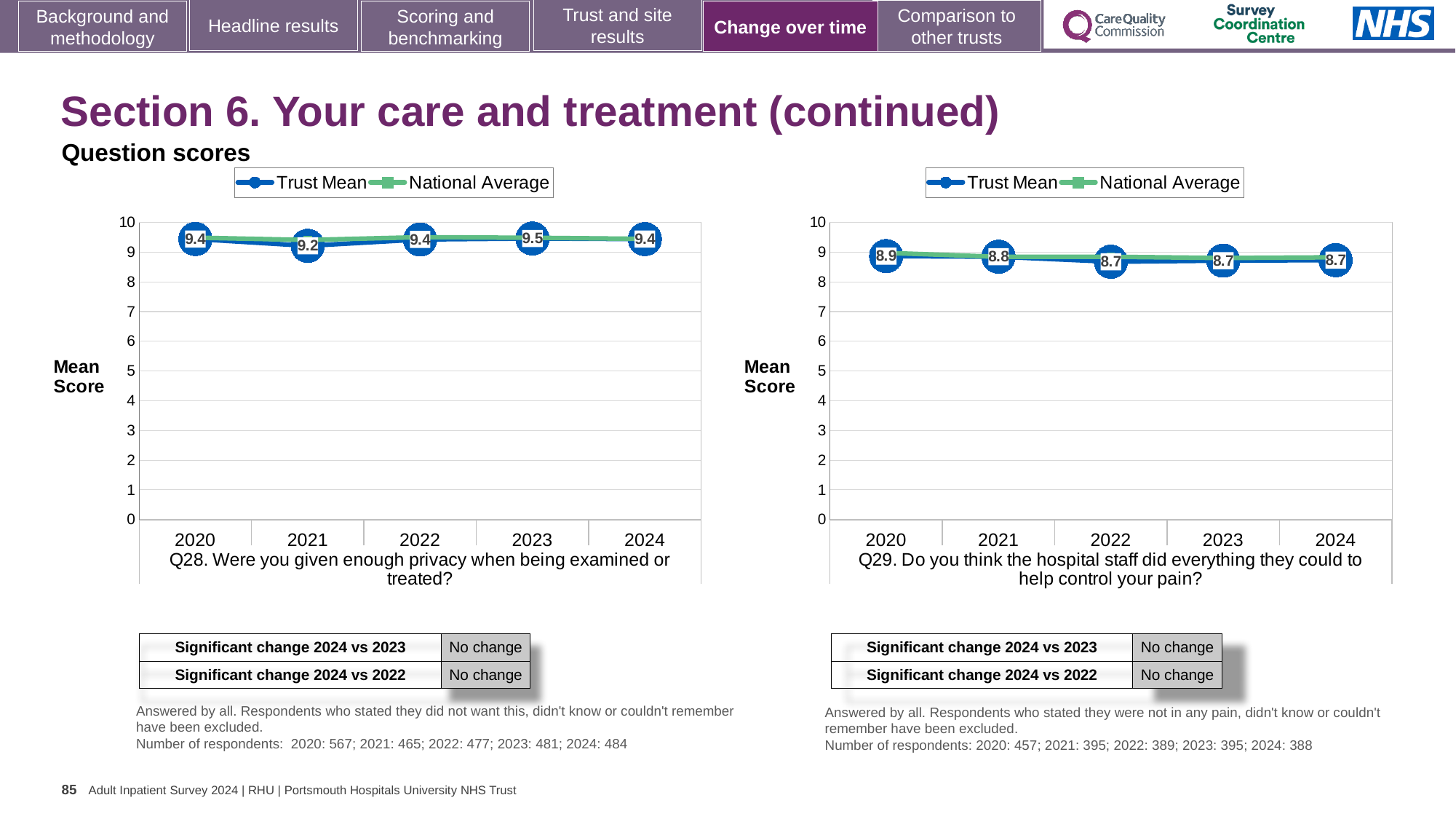
In the Q29 chart (right), what is the Trust Mean score for 2024? 8.7 In the Q28 chart (left), which year has the lowest Trust Mean score? 2021 In the Q29 chart (right), what is the difference between the Trust Mean scores for 2020 and 2022? 0.2 In the Q28 chart (left), what is the difference between the Trust Mean scores for 2023 and 2021? 0.3 Is the Trust Mean score for 2024 higher in the Q28 chart (left) or the Q29 chart (right)? Q28 chart (left) In the Q28 chart (left), what is the Trust Mean score for 2021? 9.2 In the Q29 chart (right), what is the Trust Mean score for 2020? 8.9 In the Q29 chart (right), which year has the highest Trust Mean score? 2020 In the Q29 chart (right), is the National Average value for 2024 greater or less than 8? greater In the Q28 chart (left), what is the Trust Mean score for 2023? 9.5 How many series does the legend of the Q28 chart (left) list? 2 In the Q28 chart (left), which year has the highest Trust Mean score? 2023